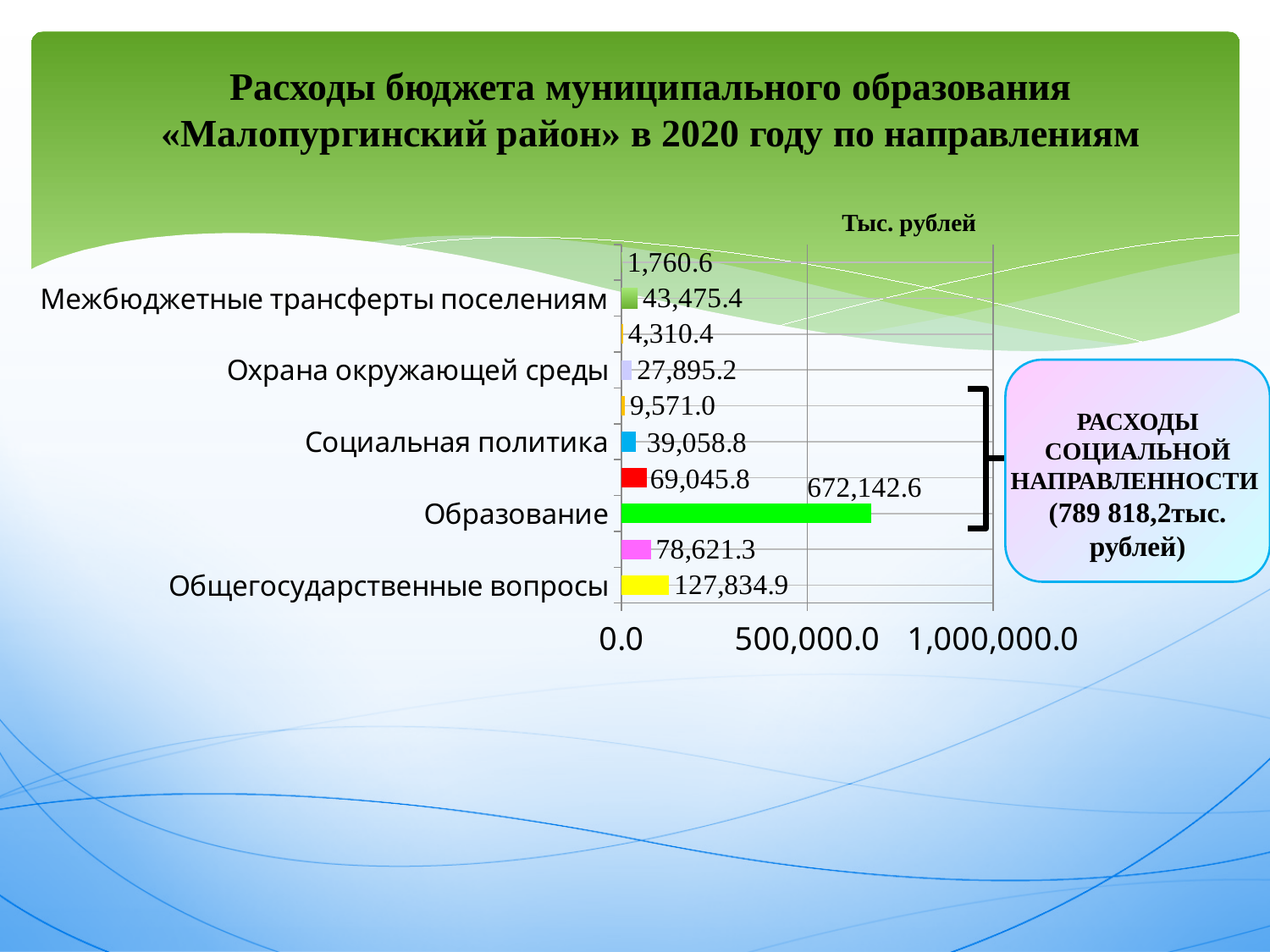
What is the value for Общегосударственные вопросы? 127,834.9 Is the value for Образование greater or less than 500,000.0? greater What is the value for Образование? 672,142.6 What is the smallest value labelled on the chart? 1,760.6 How many bars are plotted on the chart? 10 Which category has the highest value? Образование What is the difference between Образование and Общегосударственные вопросы? 544,307.7 What is the value for Социальная политика? 39,058.8 What kind of chart is shown? bar chart What is the value for Межбюджетные трансферты поселениям? 43,475.4 Which is larger, Социальная политика or Охрана окружающей среды? Социальная политика What is the value for Охрана окружающей среды? 27,895.2